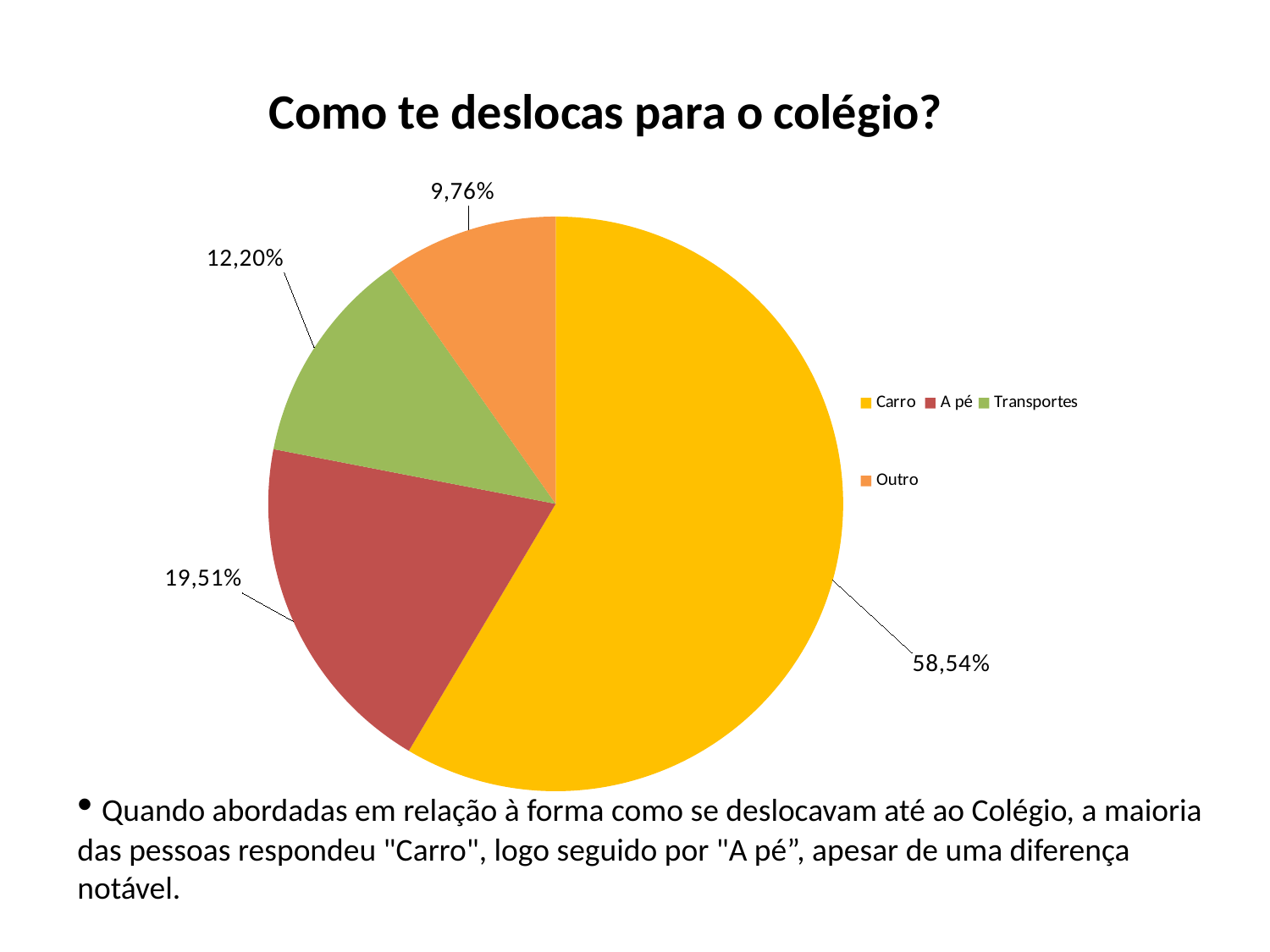
What is the difference in percentage points between the "Carro" share and the "A pé" share? 39,03% What share of the pie does "Outro" represent? 9,76% What colour is the "Carro" slice? yellow Which is larger, the share for "A pé" or the share for "Transportes"? A pé What share of the pie does "Carro" represent? 58,54% What share of the pie does "A pé" represent? 19,51% How many categories does the legend list? 4 Which category has the smallest slice of the pie? Outro Which category has the largest slice of the pie? Carro What is the title of the chart? Como te deslocas para o colégio? What kind of chart is shown on the slide? pie chart